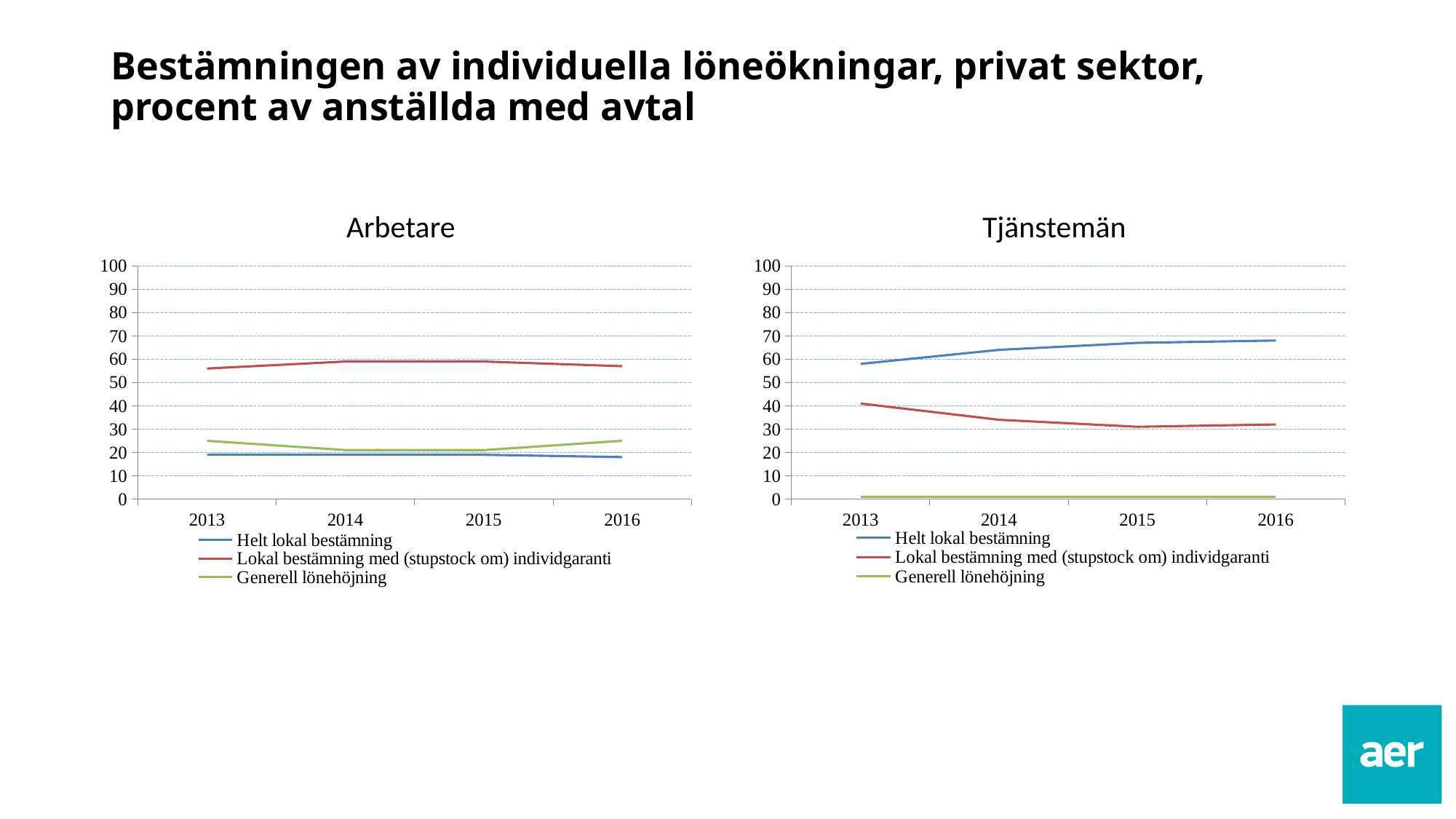
In the Arbetare chart, which series has the highest values across all years? Lokal bestämning med (stupstock om) individgaranti In the Arbetare chart, is the value for Lokal bestämning med (stupstock om) individgaranti in 2014 greater or less than 50? greater In the Tjänstemän chart, which series has the lowest values across all years? Generell lönehöjning How many series does the legend of the Tjänstemän chart list? 3 In the Tjänstemän chart, is the value for Helt lokal bestämning in 2016 greater or less than 60? greater What colour is the line for Generell lönehöjning in the Arbetare chart? green In the Tjänstemän chart, which is larger in 2013: Helt lokal bestämning or Lokal bestämning med (stupstock om) individgaranti? Helt lokal bestämning In the Tjänstemän chart, does Helt lokal bestämning rise or fall from 2013 to 2016? rise How many years are shown on the x axis of the Arbetare chart? 4 What kind of chart is the Arbetare chart? line chart In the Tjänstemän chart, is the value for Lokal bestämning med (stupstock om) individgaranti in 2016 greater or less than 50? less In the Tjänstemän chart, does Lokal bestämning med (stupstock om) individgaranti rise or fall from 2013 to 2016? fall